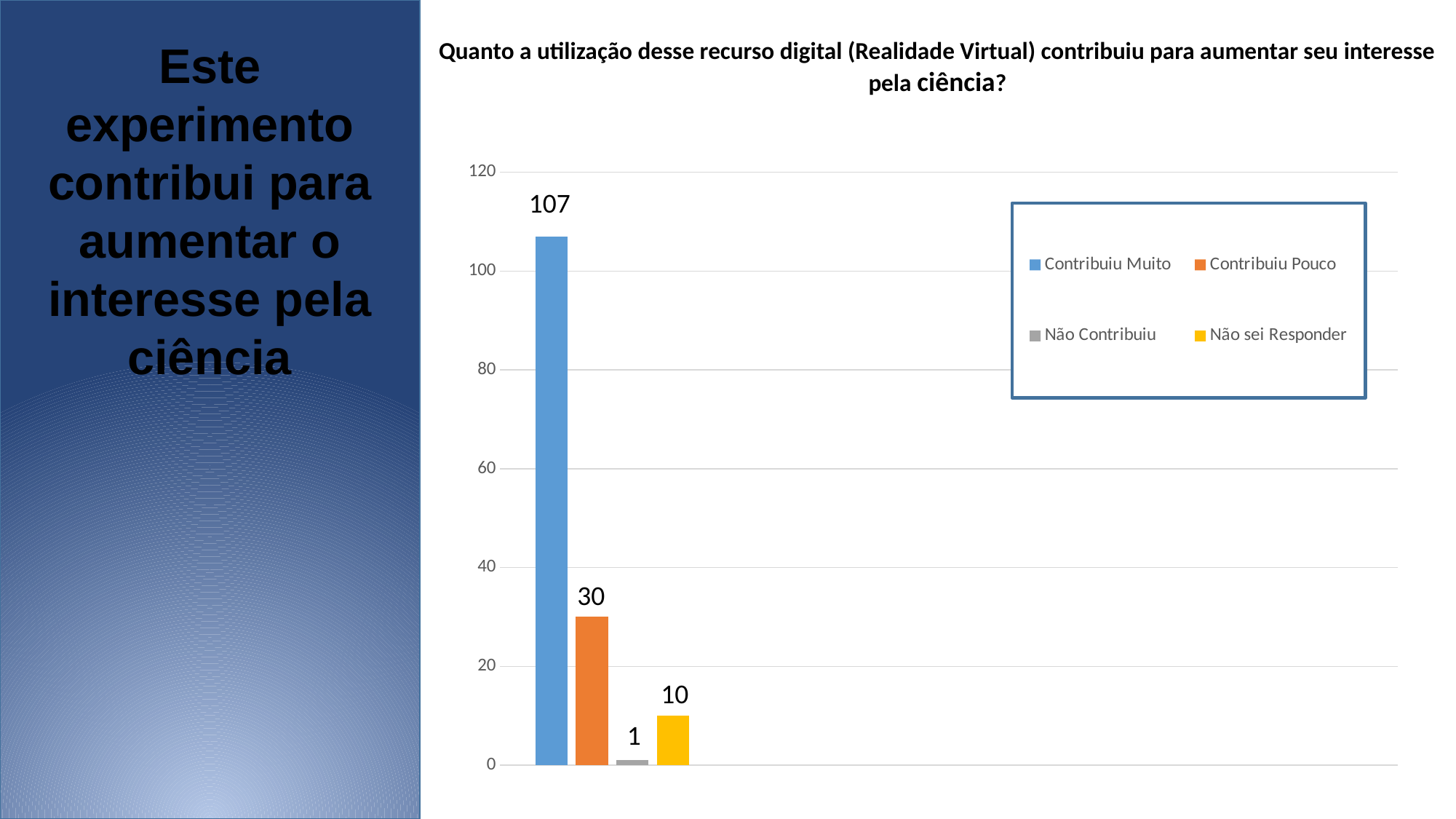
Which is larger, the value for Contribuiu Pouco or the value for Não sei Responder? Contribuiu Pouco Which response has the lowest value? Não Contribuiu Which response has the highest value? Contribuiu Muito What colour is the bar for Não sei Responder? Yellow What is the value for Não Contribuiu? 1 What is the difference between the values for Contribuiu Muito and Contribuiu Pouco? 77 How many series does the legend list? 4 What is the value for Contribuiu Pouco? 30 What is the value for Contribuiu Muito? 107 What kind of chart is shown on the slide? Bar chart What is the value for Não sei Responder? 10 Is the value for Contribuiu Muito greater or less than 100? greater